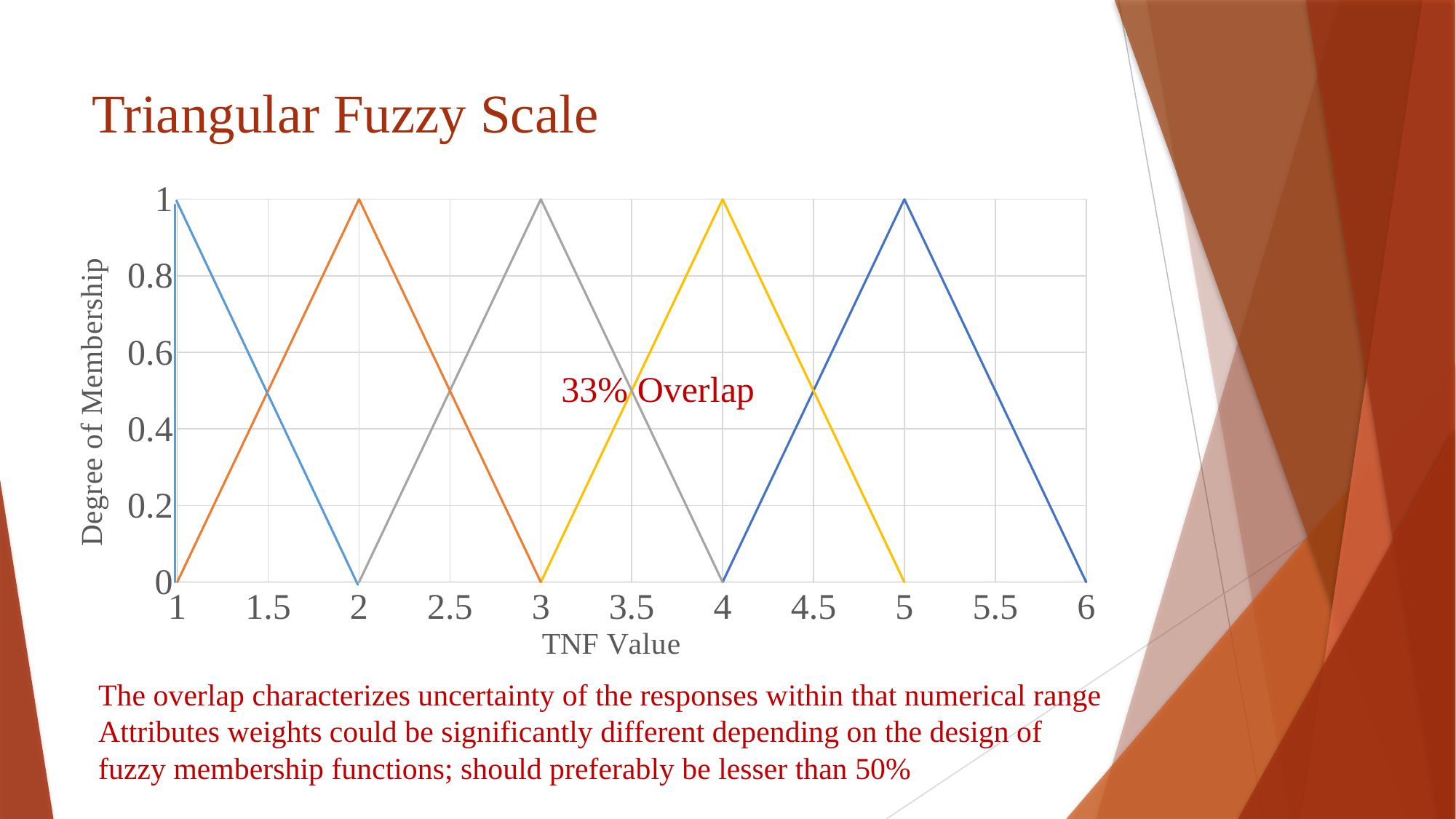
What is the degree of membership of the grey line at a TNF value of 3? 1 How many triangular membership functions are plotted on the chart? 5 Is the degree of membership of the light blue line at a TNF value of 1.5 greater or less than 0.4? greater Does the light blue line rise or fall as the TNF value goes from 1 to 2? fall What is the degree of membership of the yellow line at a TNF value of 5? 0 What is the degree of membership of the light blue line at a TNF value of 2? 0 Is the degree of membership of the grey line at a TNF value of 3.5 greater or less than 0.6? less What overlap percentage is annotated on the chart? 33% Overlap What is the degree of membership of the orange line at a TNF value of 2? 1 What kind of chart is shown on the slide? line chart What is the degree of membership of the dark blue line at a TNF value of 6? 0 What is the title of the x axis of the chart? TNF Value